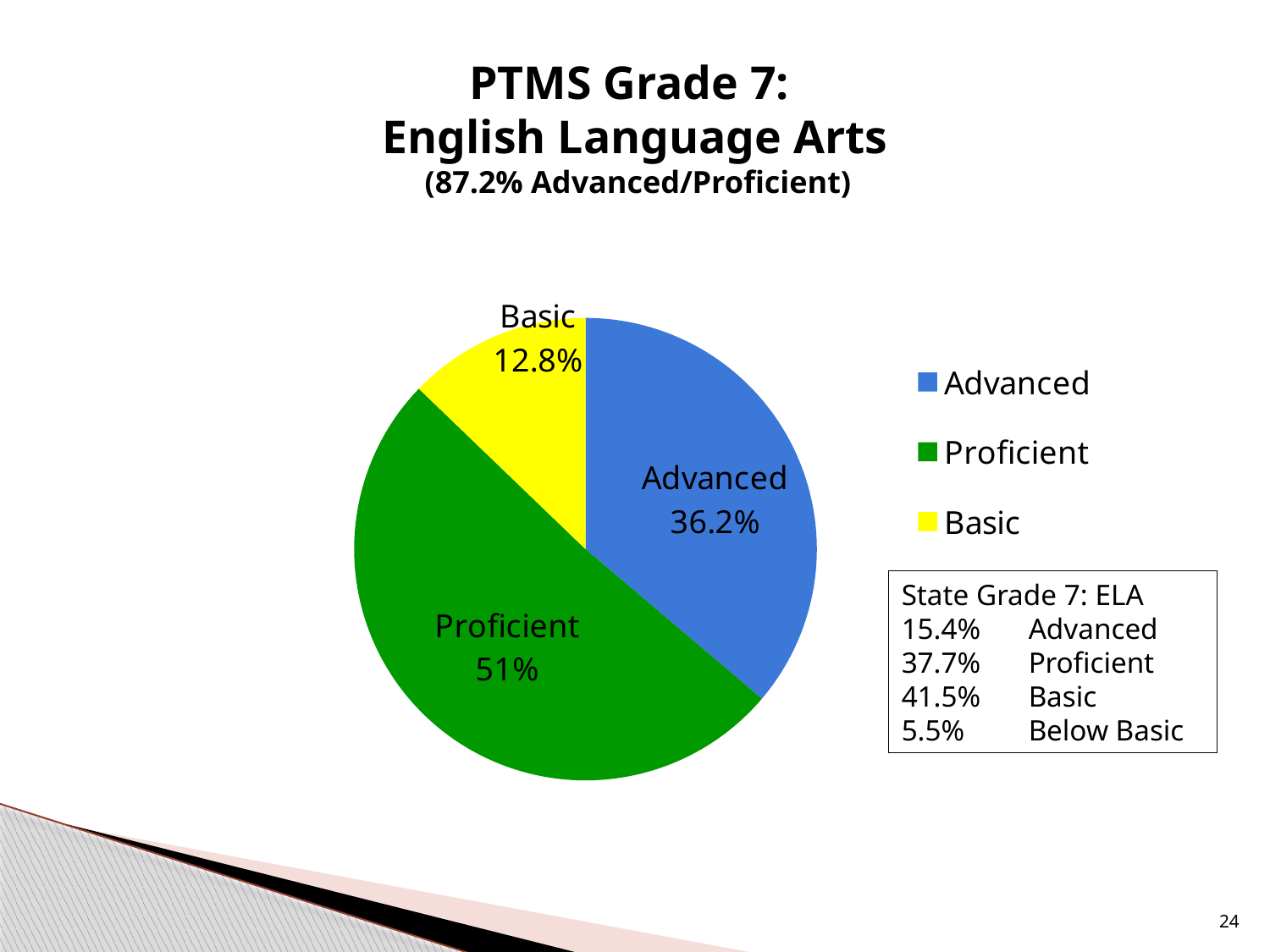
What colour is the Proficient slice? green How many entries does the legend list? 3 How many slices does the pie chart have? 3 What is the difference in percentage points between the Proficient and Advanced slices? 14.8 Which category has the largest slice of the pie? Proficient What percentage of PTMS Grade 7 students scored Advanced in English Language Arts? 36.2% What is the combined percentage of Advanced and Proficient shown in the chart title? 87.2% What percentage of PTMS Grade 7 students scored Proficient in English Language Arts? 51% Which slice is larger, Advanced or Basic? Advanced Which category has the smallest slice of the pie? Basic What kind of chart is shown on the slide? pie chart What percentage of PTMS Grade 7 students scored Basic in English Language Arts? 12.8%